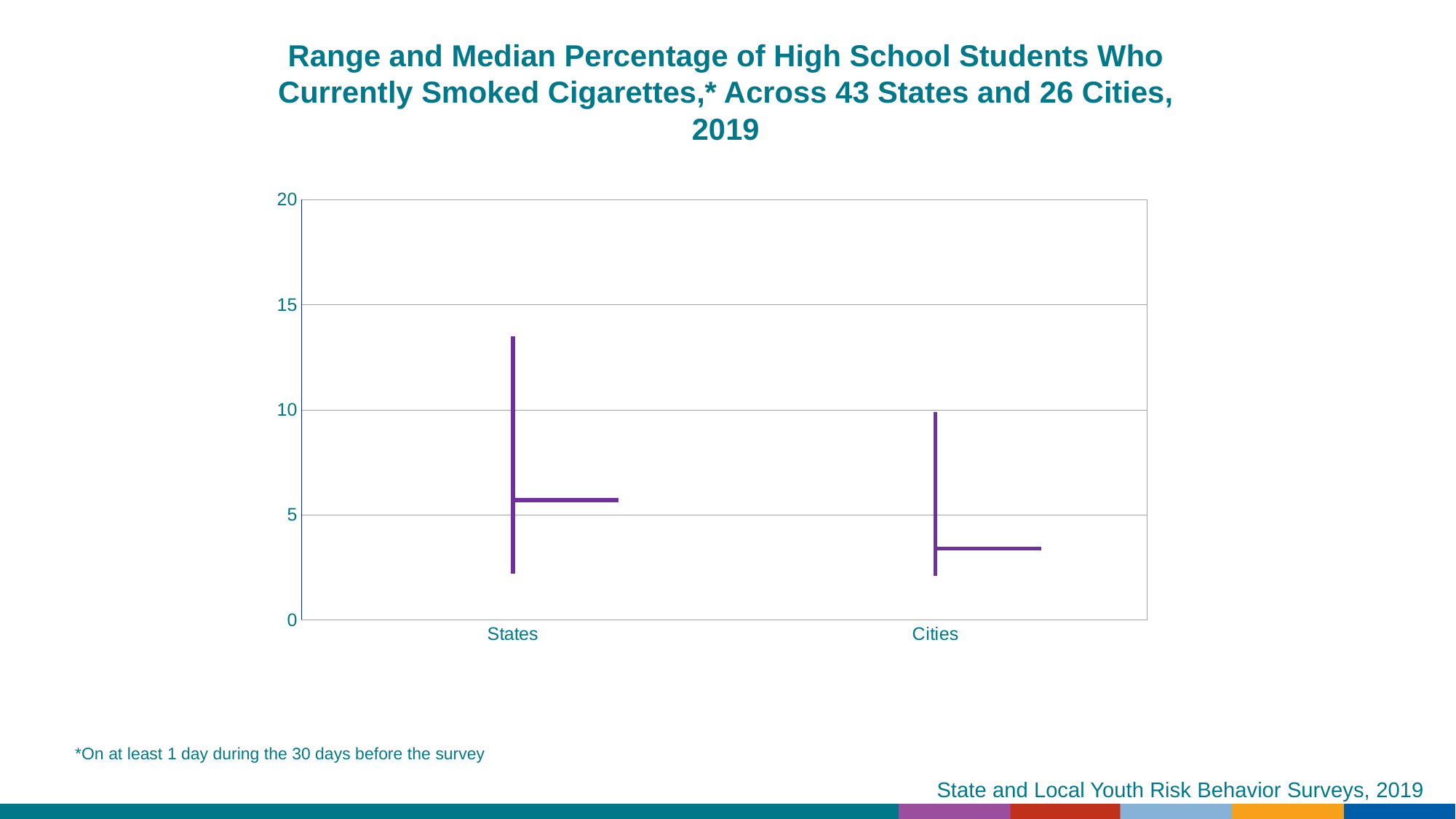
Which category has the higher top of its range, States or Cities? States Is the median value for States greater or less than 5? greater Is the median value for States greater or less than 10? less Is the median value for Cities greater or less than 5? less How many categories are shown on the x axis of the chart? 2 What is the highest value shown on the y axis of the chart? 20 According to the chart title, how many states and how many cities are included? 43 states and 26 cities Which category has the higher median percentage, States or Cities? States